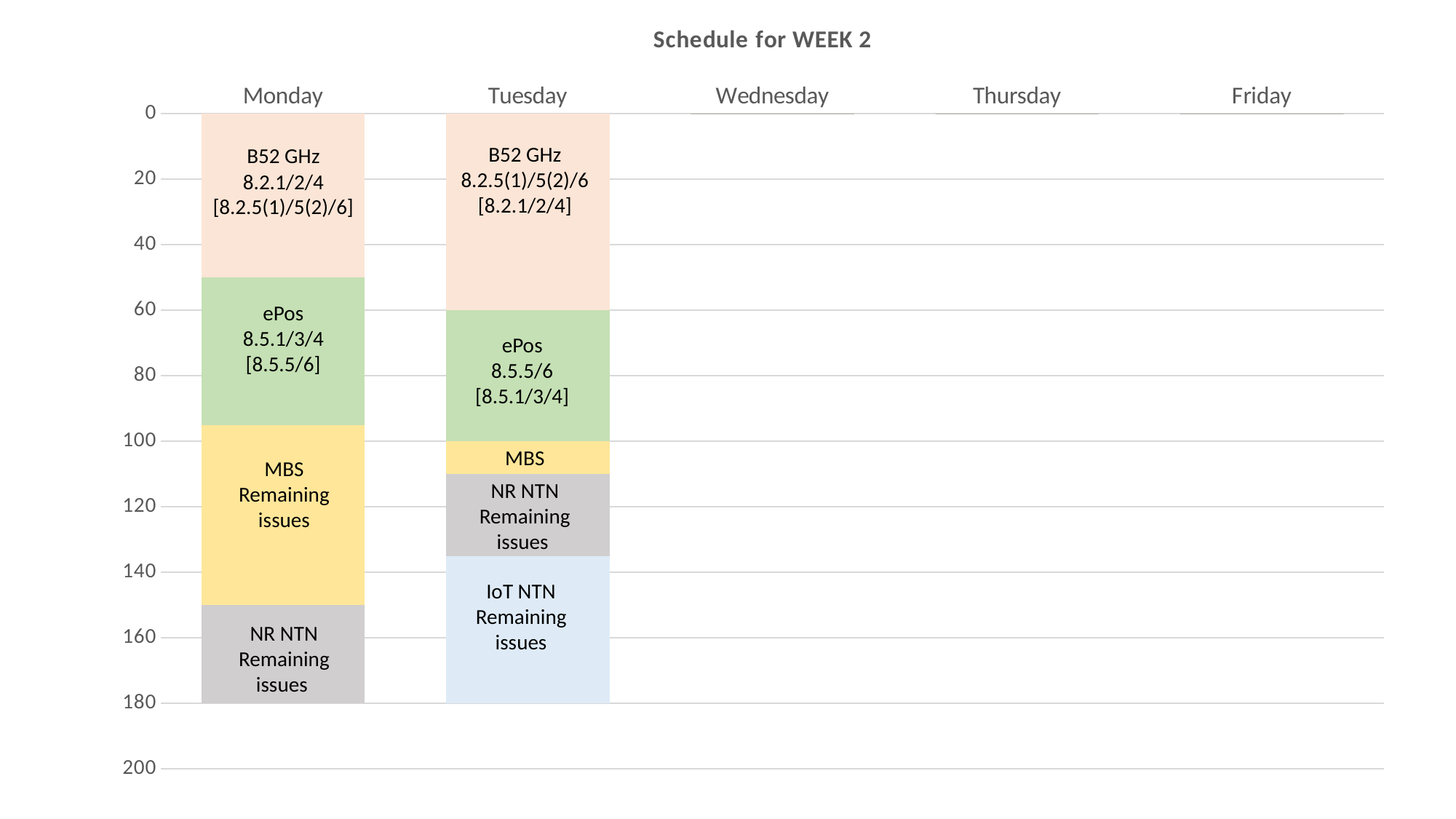
Which segment appears in the Tuesday bar but not in the Monday bar? IoT NTN Remaining issues How many days are listed along the top of the chart? 5 Is the B52 GHz segment larger on Monday or on Tuesday? Tuesday At what axis value does the Monday bar end? 180 How many segments make up the Monday bar? 4 At what axis value does the B52 GHz segment of the Tuesday bar end? 60 At what axis value does the ePos segment of the Tuesday bar end? 100 How many segments make up the Tuesday bar? 5 What is the title of the chart? Schedule for WEEK 2 What kind of chart is shown on the slide? Stacked bar chart Is the MBS segment larger on Monday or on Tuesday? Monday